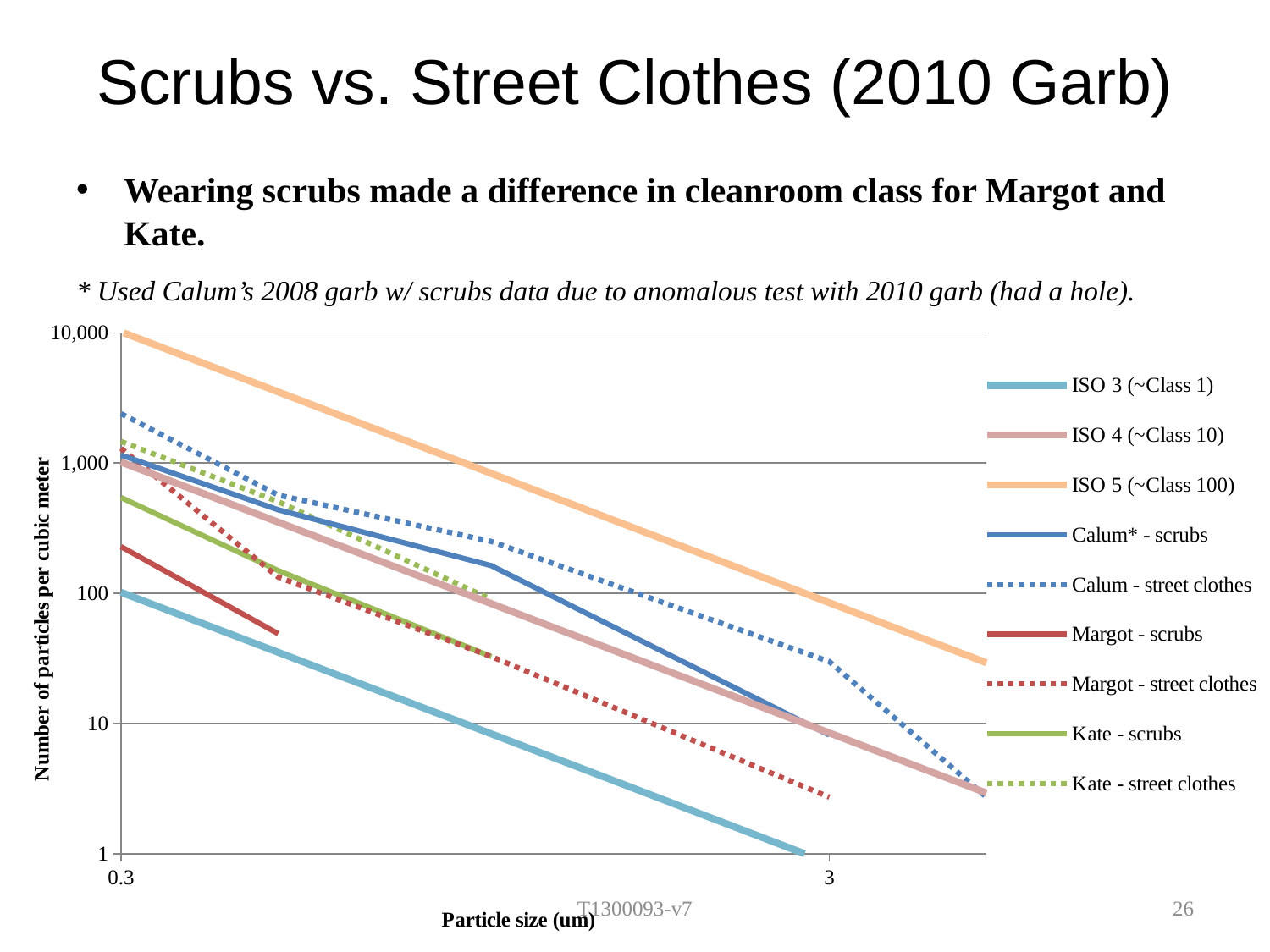
Do the plotted lines rise or fall as particle size increases along the x axis? fall How many series does the chart legend list? 9 What kind of chart is shown on the slide? line chart Which series has the lowest value at particle size 0.3? ISO 3 (~Class 1) What is the label of the chart's x axis? Particle size (um) Is the value for Kate - scrubs at particle size 0.3 greater or less than 100? greater At particle size 0.3, which is larger: Kate - street clothes or Kate - scrubs? Kate - street clothes Which series has the highest value at particle size 0.3? ISO 5 (~Class 100) What is the label of the chart's y axis? Number of particles per cubic meter